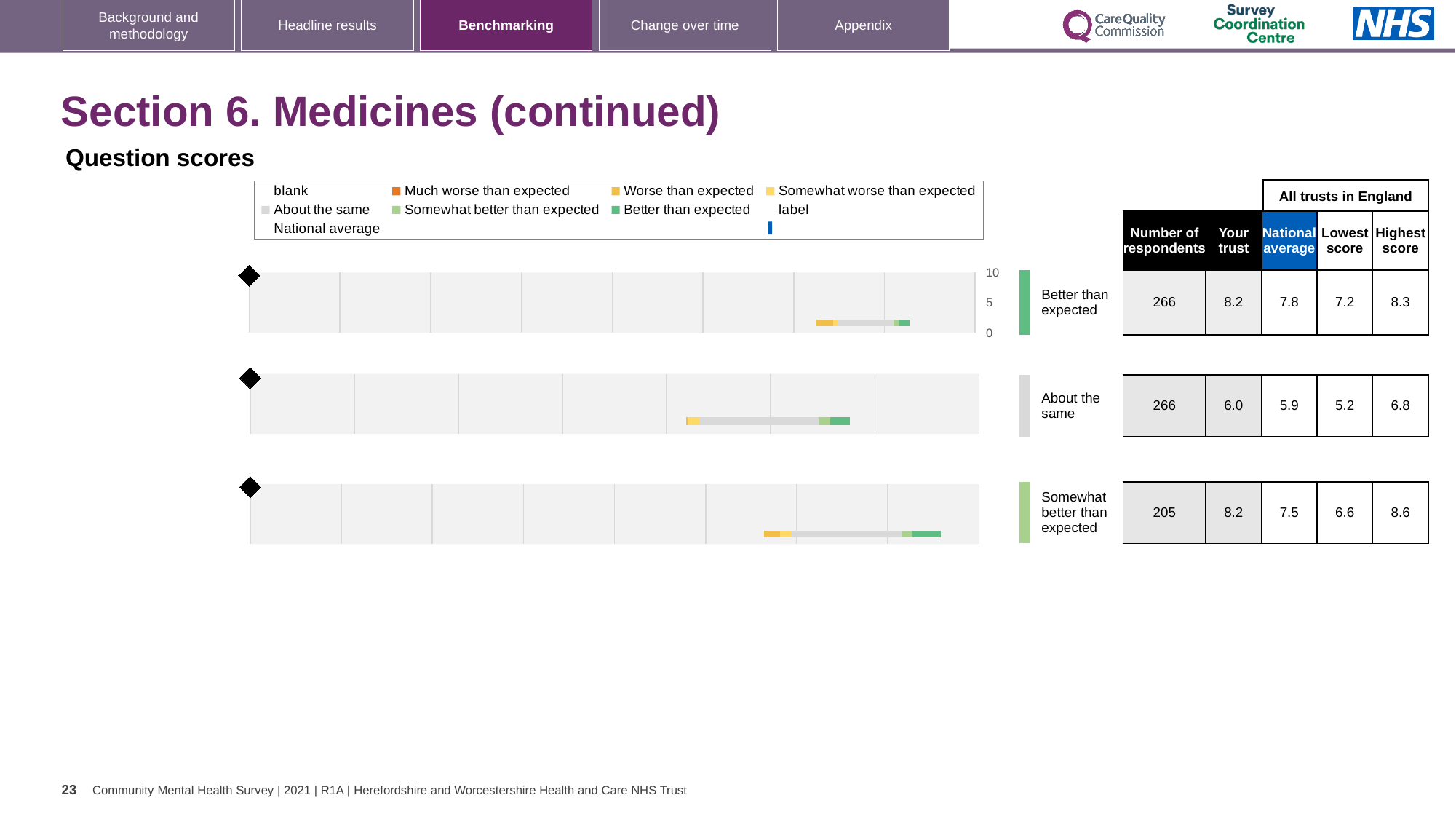
For the bottom chart (rated 'Somewhat better than expected'), what is the difference between the highest score and the lowest score? 2.0 How many benchmarking charts are shown on the slide? 3 For the middle chart (rated 'About the same'), what is the national average score? 5.9 What is the maximum value shown on the vertical axis of the top chart? 10 For the top chart (rated 'Better than expected'), what is the difference between the 'Your trust' score and the national average? 0.4 For the top chart (rated 'Better than expected'), what is the 'Your trust' score shown in the table? 8.2 For the bottom chart (rated 'Somewhat better than expected'), how many respondents are listed? 205 What kind of chart is used for the benchmarking rows on this slide? Bar chart Which of the three charts has the highest 'Highest score' value in the table? Somewhat better than expected (bottom chart) For the middle chart (rated 'About the same'), which is larger: the 'Your trust' score or the national average? Your trust For the top chart (rated 'Better than expected'), what is the lowest score among all trusts in England? 7.2 Which of the three charts has the lowest 'Lowest score' value in the table? About the same (middle chart)